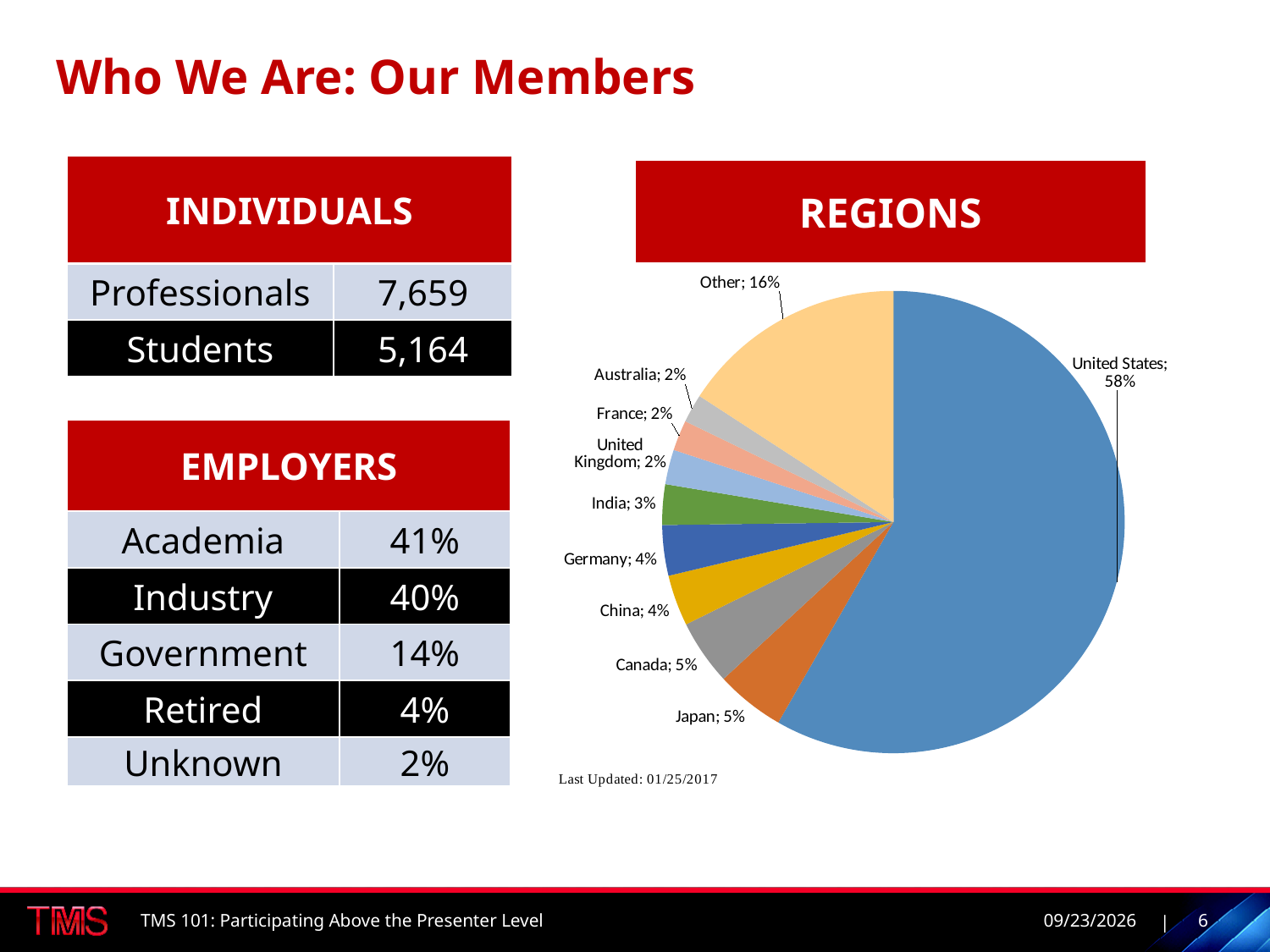
How many slices does the REGIONS pie chart have? 10 In the REGIONS pie chart, what is the difference between the Japan share and the United Kingdom share? 3% What percentage is shown for India in the REGIONS pie chart? 3% In the REGIONS pie chart, what is the difference between the United States share and the Other share? 42% What percentage does the Other slice represent in the REGIONS pie chart? 16% What share of members is from the United States in the REGIONS pie chart? 58% In the REGIONS pie chart, which is larger, the share for Canada or the share for Germany? Canada What is the share for Japan in the REGIONS pie chart? 5% Which region has the largest slice in the REGIONS pie chart? United States What kind of chart is shown under the REGIONS heading? pie chart What is the combined share of China and Germany in the REGIONS pie chart? 8% What is the title of the pie chart on the slide? REGIONS